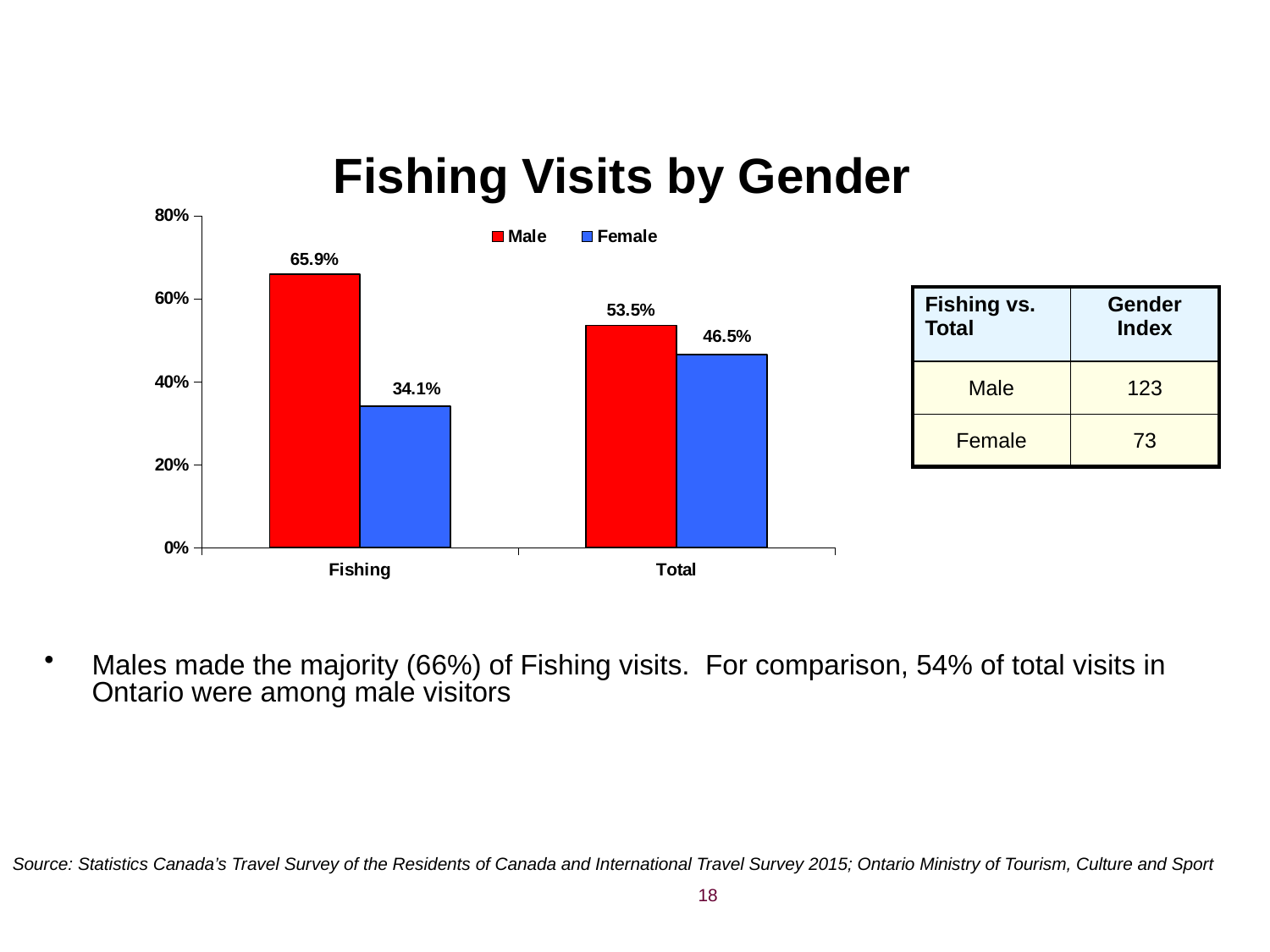
What is the Female value for Fishing? 34.1% What type of chart is shown on the slide? Bar chart Is the Female value for Fishing greater or less than 40%? less What is the Male value for Fishing? 65.9% What is the difference between the Male and Female values for Fishing? 31.8% Which is larger for Total, the Male value or the Female value? Male How many series does the legend list? 2 Which bar in the chart has the lowest value? Female, Fishing How many categories are shown on the x axis? 2 What is the Female value for Total? 46.5% Which bar in the chart has the highest value? Male, Fishing What is the Male value for Total? 53.5%